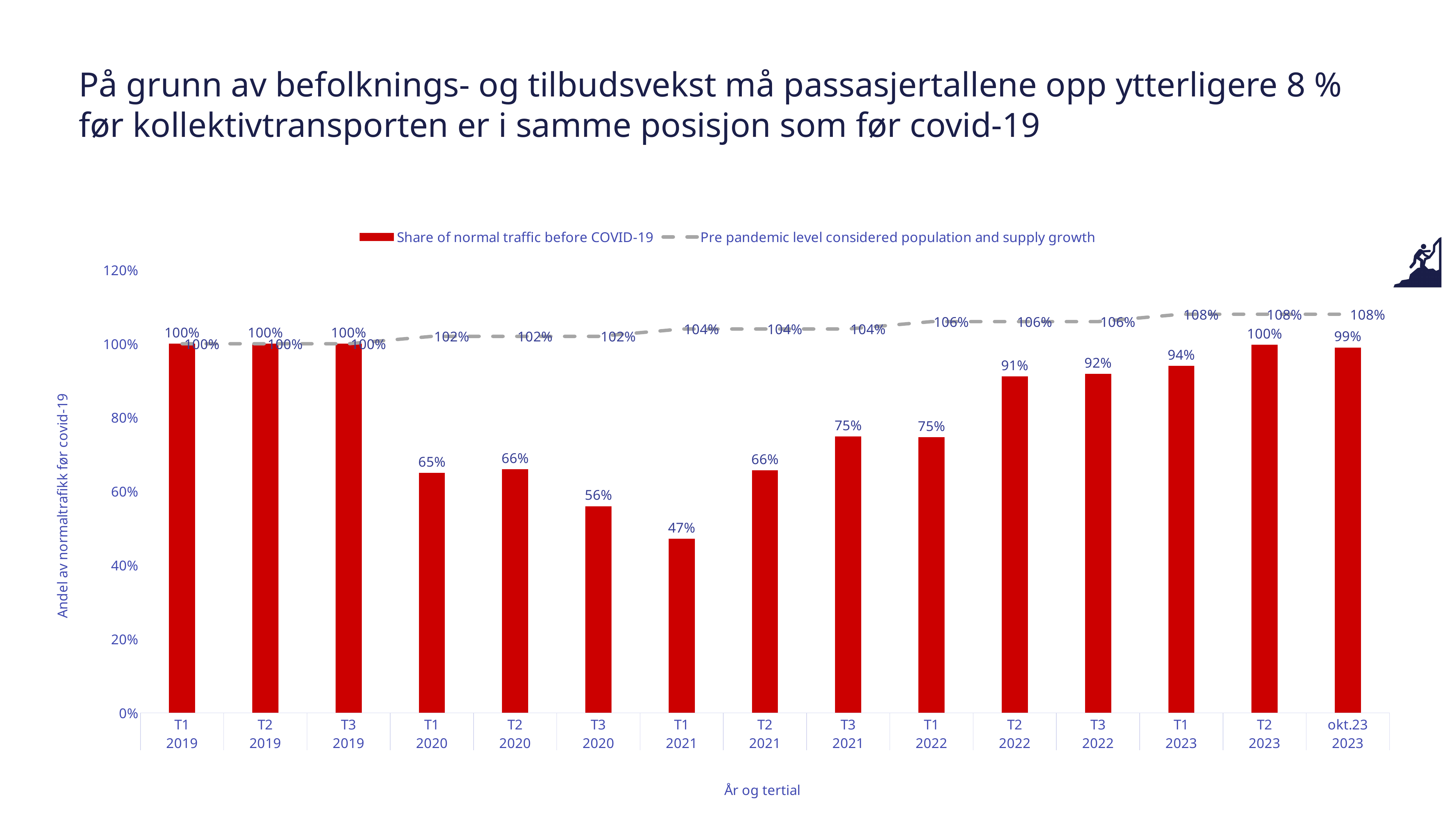
What is the difference in 'Share of normal traffic before COVID-19' between T2 2022 and T1 2022? 16% Which category has the lowest value for 'Share of normal traffic before COVID-19'? T1 2021 How many series does the legend list? 2 What kind of chart is used for the 'Share of normal traffic before COVID-19' series? Bar chart What is the value of 'Pre pandemic level considered population and supply growth' for okt.23 2023? 108% Does the 'Pre pandemic level considered population and supply growth' series rise or fall from T1 2019 to okt.23 2023? Rise What is the value of 'Share of normal traffic before COVID-19' for T1 2021? 47% Which is larger, the 'Share of normal traffic before COVID-19' for T3 2020 or for T1 2020? T1 2020 What is the value of 'Share of normal traffic before COVID-19' for T3 2022? 92% How many categories are shown on the x axis? 15 What is the label of the x axis? År og tertial What is the difference between the 'Pre pandemic level considered population and supply growth' and the 'Share of normal traffic before COVID-19' for okt.23 2023? 9%